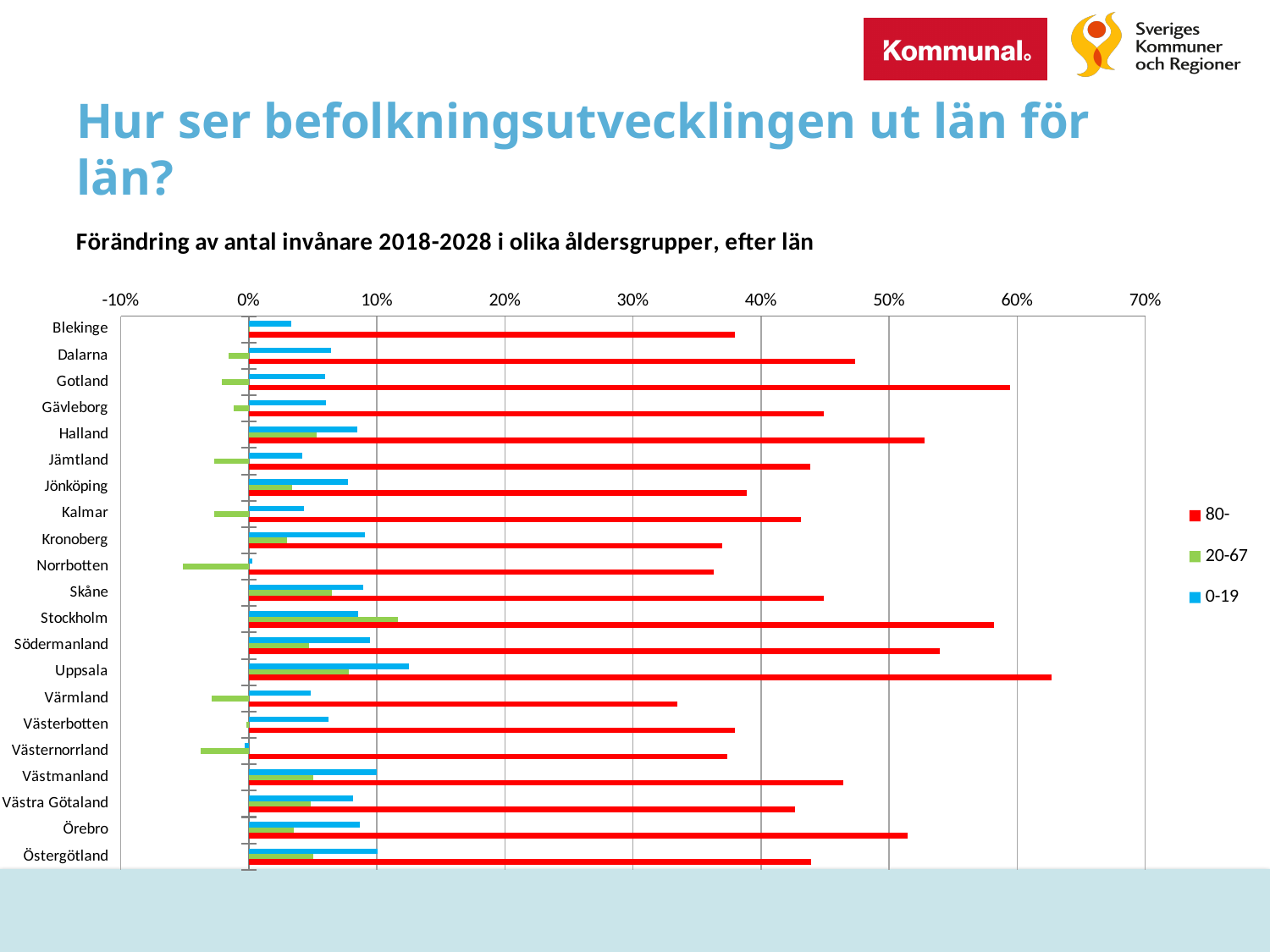
What is the title of the chart? Förändring av antal invånare 2018-2028 i olika åldersgrupper, efter län Which county has the lowest value for the 20-67 series? Norrbotten Which county has the lowest value for the 80- series? Värmland Which county has the highest value for the 80- series? Uppsala What kind of chart is shown on the slide? bar chart Which county has the highest value for the 0-19 series? Uppsala How many counties (categories) are shown on the chart? 21 Is the 80- value for Gotland greater or less than 50%? greater How many series does the legend list? 3 Is the 80- value for Värmland greater or less than 40%? less Which is larger, the 80- value for Uppsala or the 80- value for Blekinge? Uppsala Which county has the highest value for the 20-67 series? Stockholm